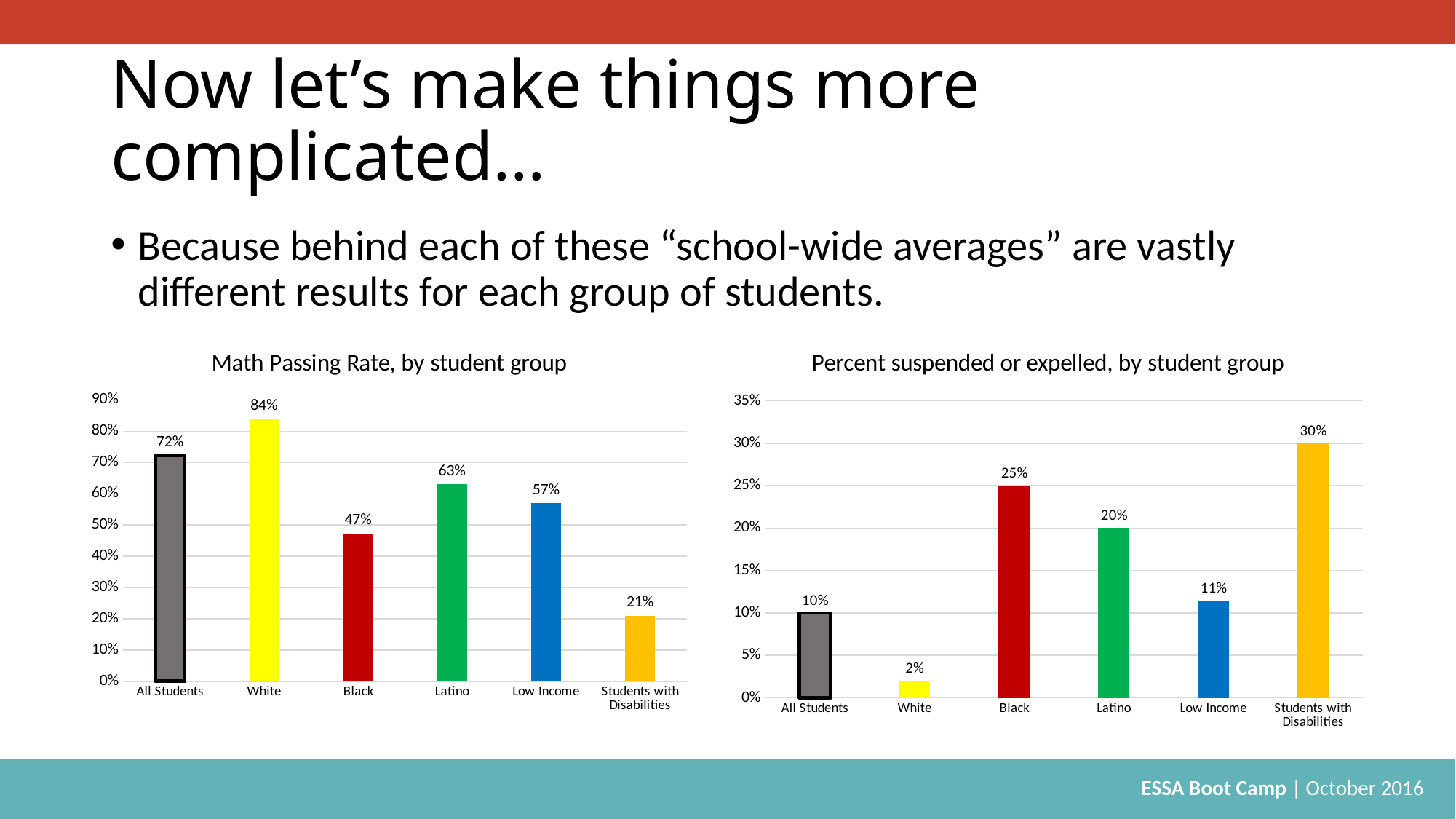
In the 'Math Passing Rate, by student group' chart, which student group has the lowest passing rate? Students with Disabilities What is the title of the chart on the right side of the slide? Percent suspended or expelled, by student group In the 'Percent suspended or expelled, by student group' chart, what is the difference between the values for Students with Disabilities and All Students? 20% In the 'Percent suspended or expelled, by student group' chart, what is the value for Black? 25% What kind of chart is the 'Math Passing Rate, by student group' chart? Bar chart In the 'Math Passing Rate, by student group' chart, which is larger, the value for Latino or the value for Low Income? Latino In the 'Math Passing Rate, by student group' chart, what is the value for White? 84% In the 'Math Passing Rate, by student group' chart, how many student groups are shown? 6 In the 'Percent suspended or expelled, by student group' chart, is the value for Latino greater or less than 15%? greater In the 'Percent suspended or expelled, by student group' chart, which student group has the highest value? Students with Disabilities In the 'Math Passing Rate, by student group' chart, what is the difference between the values for White and Black? 37% In the 'Percent suspended or expelled, by student group' chart, which student group has the lowest value? White